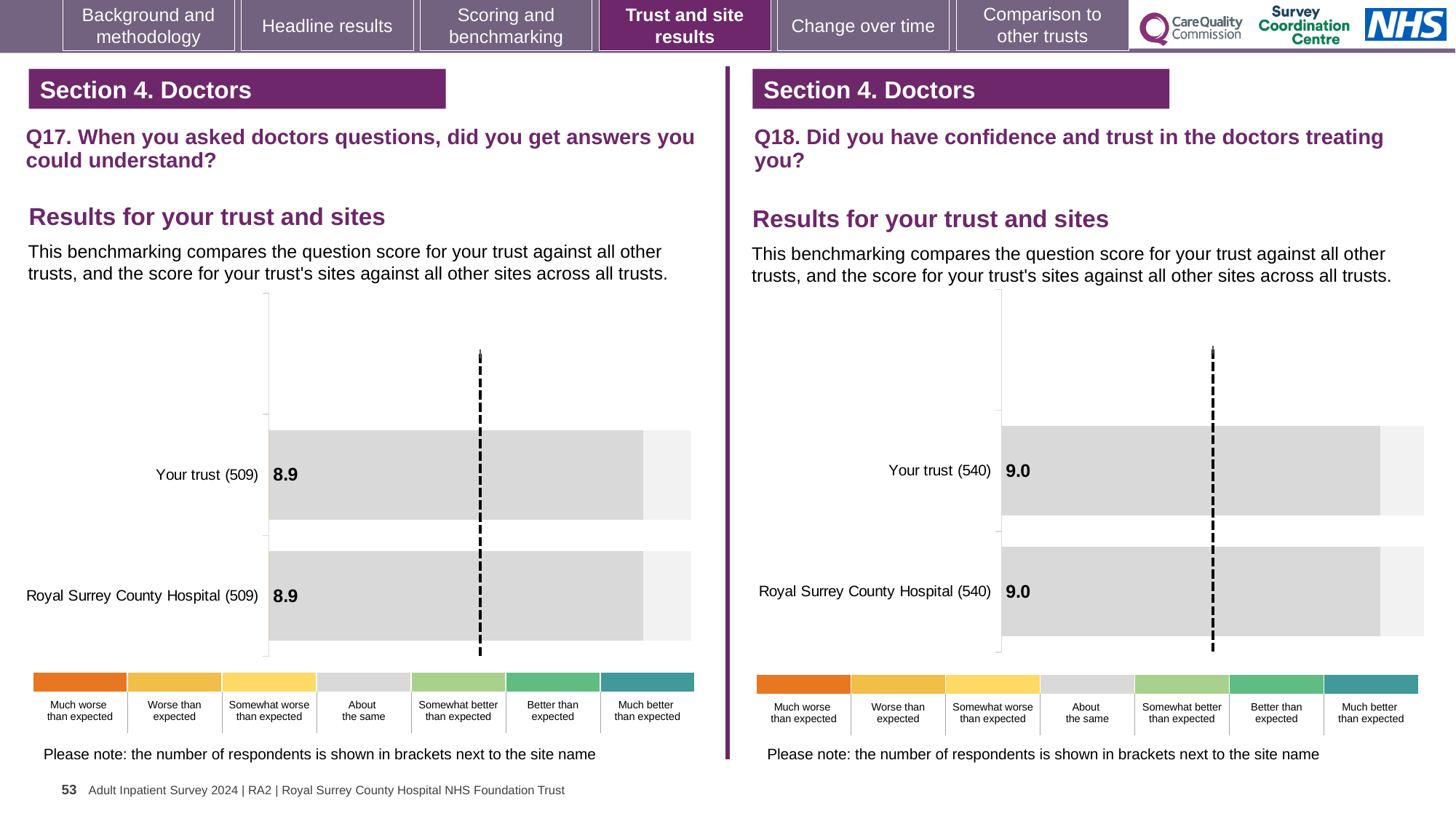
In the Q18 chart on the right, what is the score for Royal Surrey County Hospital? 9.0 In the Q18 chart on the right, how many respondents are shown in brackets next to Royal Surrey County Hospital? 540 How many bars are plotted in the Q18 chart on the right? 2 In the Q17 chart on the left, what is the score for Royal Surrey County Hospital? 8.9 In the Q17 chart on the left, what is the score for Your trust? 8.9 How many bars are plotted in the Q17 chart on the left? 2 In the Q18 chart on the right, what is the difference between the score for Your trust and the score for Royal Surrey County Hospital? 0.0 In the Q18 chart on the right, what is the score for Your trust? 9.0 In the Q17 chart on the left, how many respondents are shown in brackets next to Your trust? 509 What kind of chart is used for the Q17 results on the left? Bar chart In the Q17 chart on the left, what is the difference between the score for Your trust and the score for Royal Surrey County Hospital? 0.0